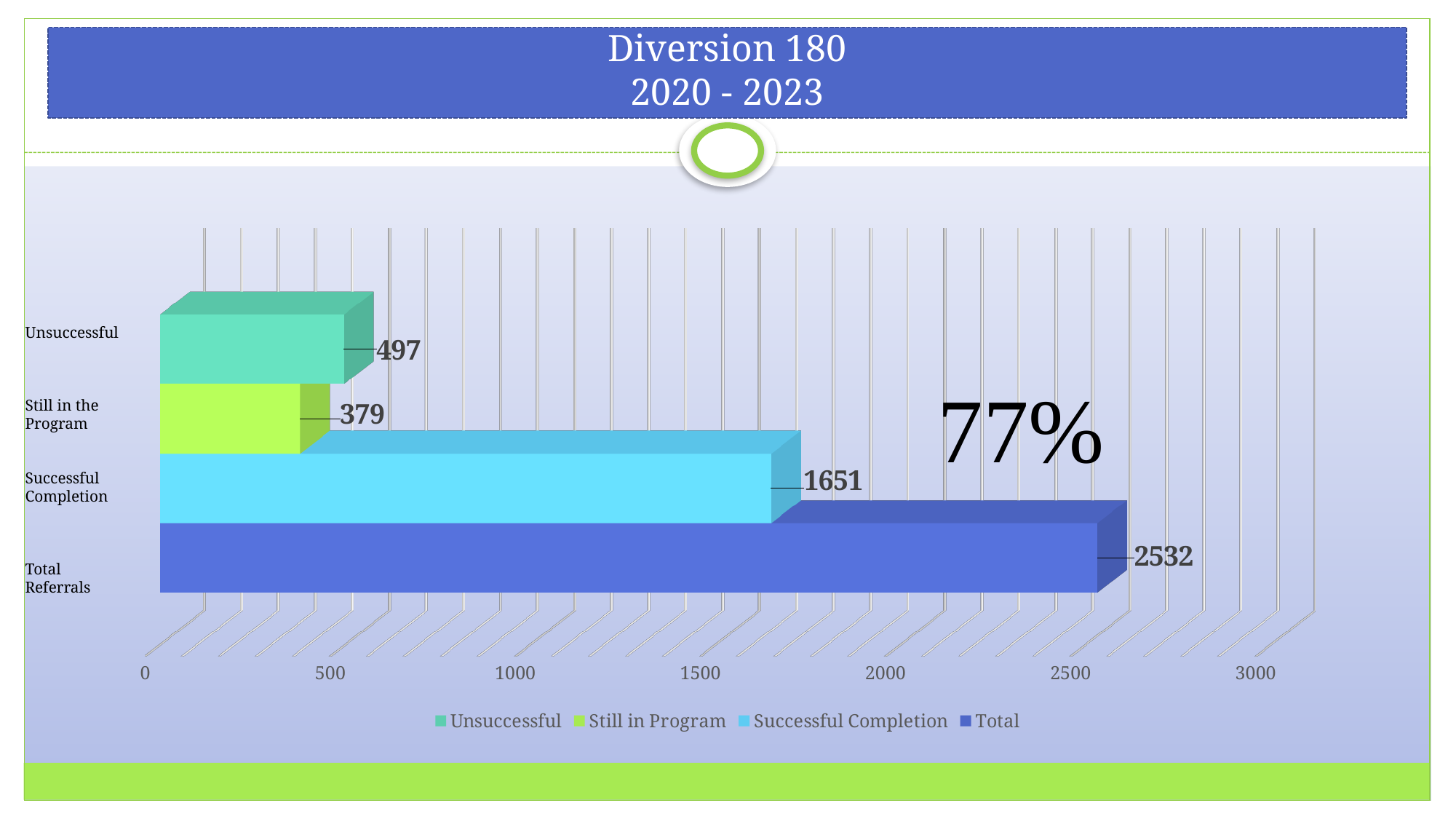
Is the value for Successful Completion greater or less than 1500? greater What is the title of the slide containing the chart? Diversion 180 2020 - 2023 What is the value for Total Referrals? 2532 What is the value for Successful Completion? 1651 What kind of chart is shown on the slide? bar chart Which is larger, Unsuccessful or Still in the Program? Unsuccessful What is the value for Still in the Program? 379 How many categories are shown on the chart? 4 Which category has the highest value? Total Referrals Which category has the lowest value? Still in the Program What is the value for Unsuccessful? 497 What is the difference between Successful Completion and Unsuccessful? 1154